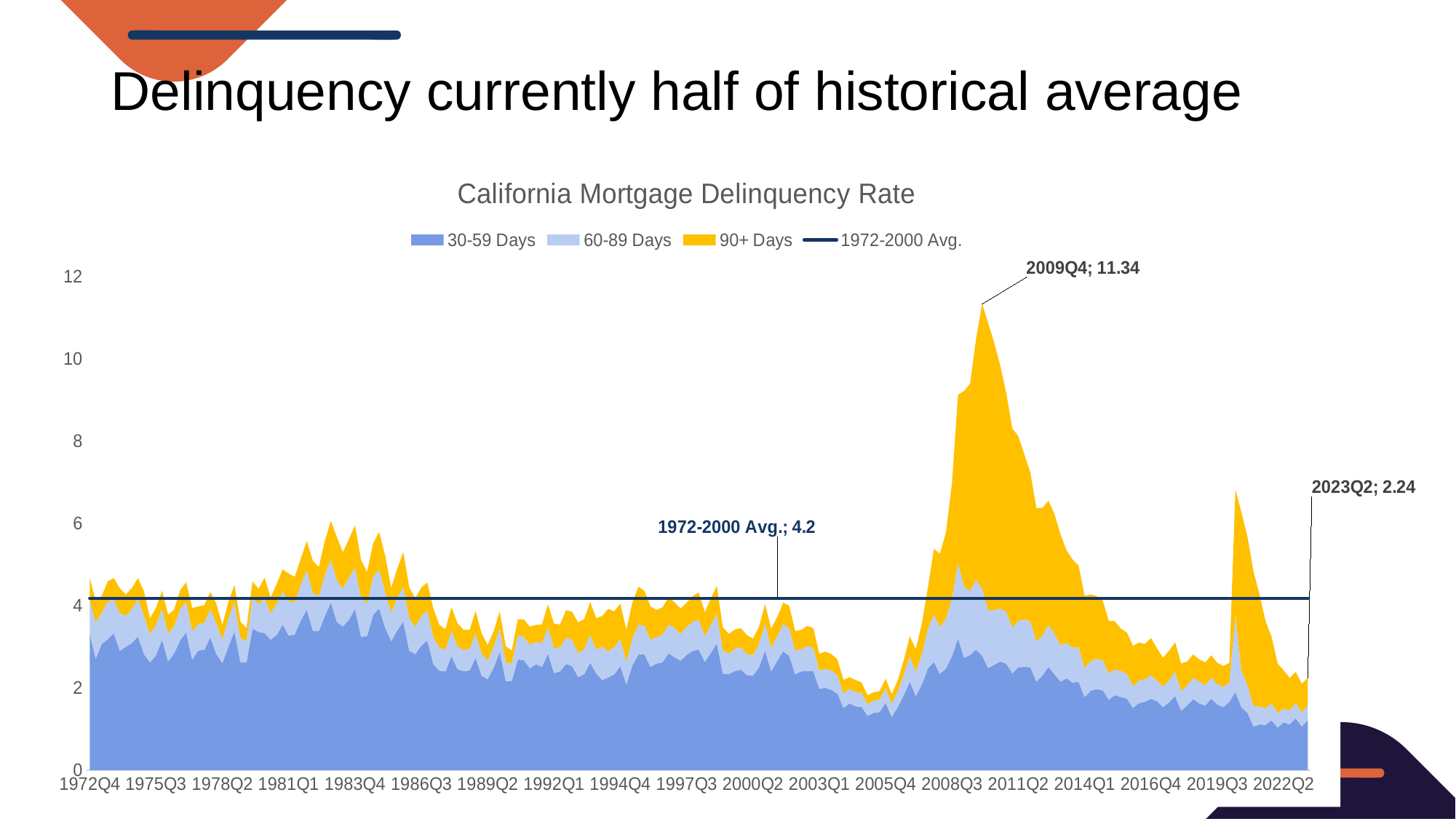
What kind of chart is shown on the slide? Stacked area chart with a line What is the difference between the 1972-2000 Avg. value and the labelled value at 2023Q2? 1.96 What is the difference between the labelled value at 2009Q4 and the labelled value at 2023Q2? 9.10 Which is larger: the 1972-2000 Avg. value or the labelled value at 2023Q2? 1972-2000 Avg. Which series is shown in yellow? 90+ Days What is the labelled total delinquency rate at 2023Q2? 2.24 How many series does the legend list? 4 What is the labelled total delinquency rate at 2009Q4? 11.34 What is the value of the 1972-2000 Avg. line? 4.2 What is the title of the chart? California Mortgage Delinquency Rate In which quarter does the total delinquency rate reach its highest labelled value? 2009Q4 Is the total delinquency rate at 2009Q4 greater or less than 10? greater